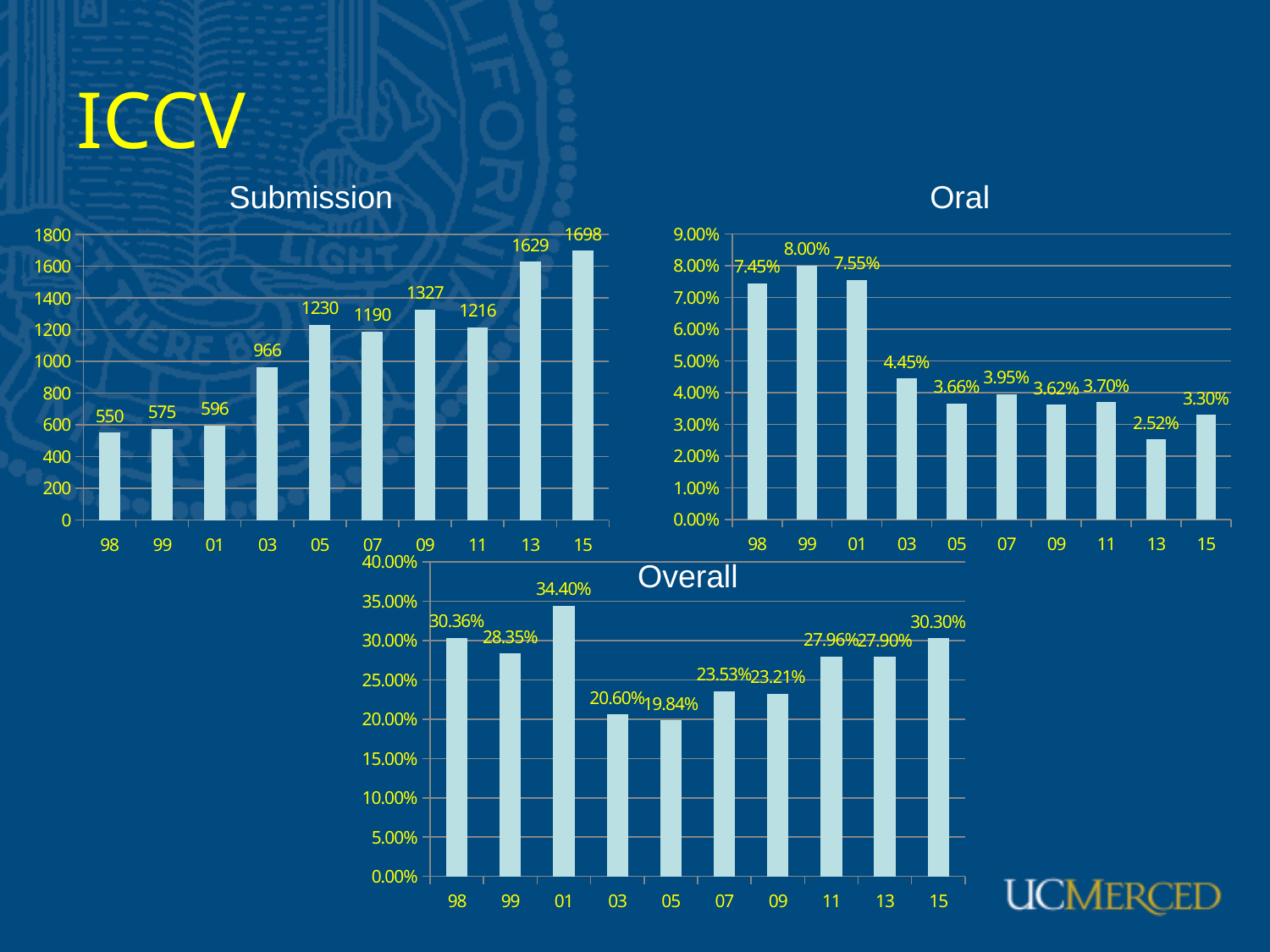
In the Overall chart, is the value for 11 greater or less than 25.00%? greater In the Oral chart, do the values generally rise or fall from 98 to 15? fall What type of chart is the Submission chart? bar chart In the Submission chart, which year has the highest value? 15 In the Overall chart, which year has the lowest value? 05 In the Oral chart, which year has the lowest value? 13 In the Oral chart, what is the value for 99? 8.00% In the Submission chart, how many years are shown on the x axis? 10 In the Submission chart, what is the difference between the values for 15 and 13? 69 In the Submission chart, what is the value for 03? 966 In the Oral chart, which is larger, the value for 05 or the value for 07? 07 In the Overall chart, what is the value for 01? 34.40%